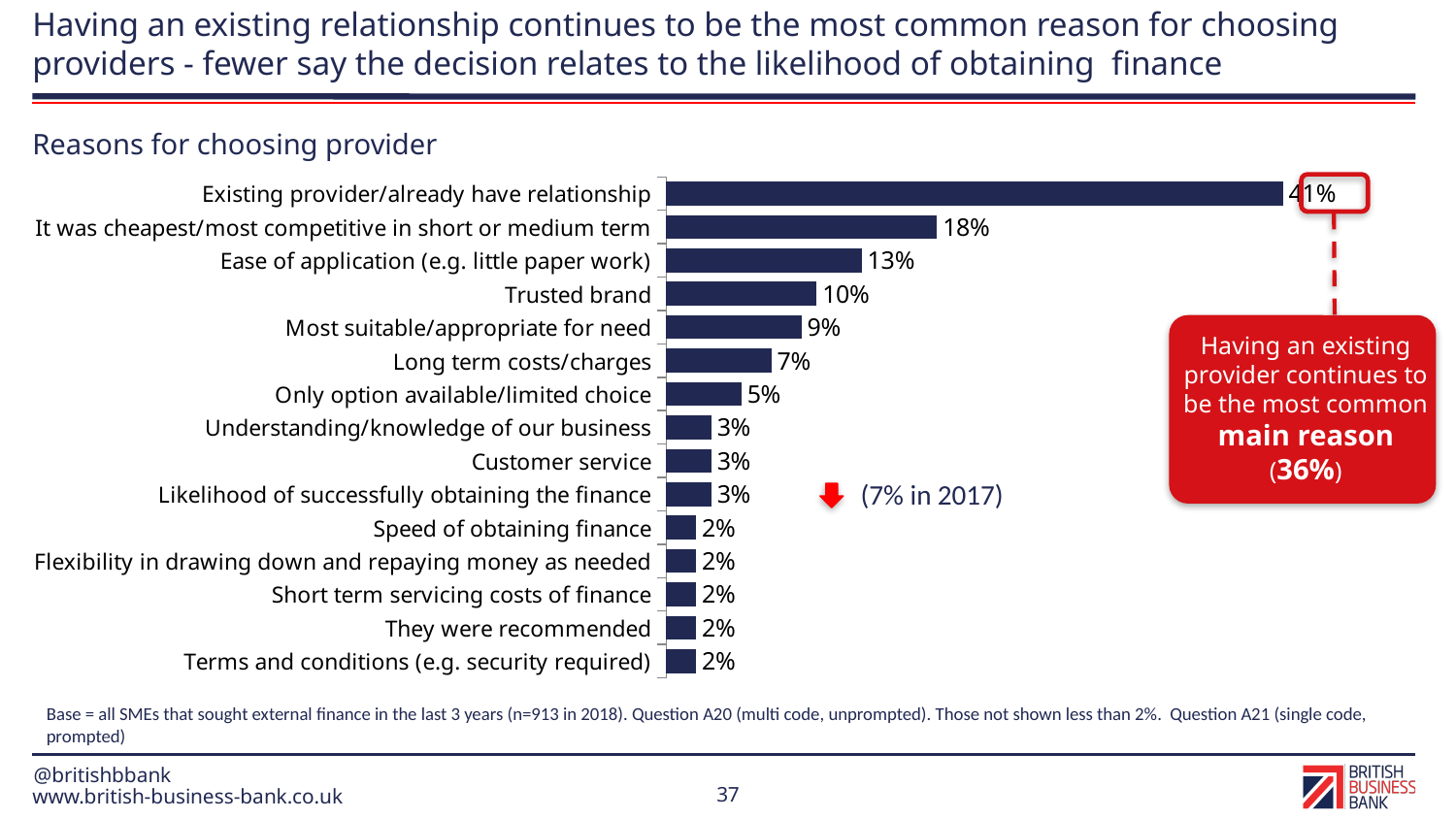
What is the value for 'Only option available/limited choice'? 5% Which is larger: 'Most suitable/appropriate for need' or 'Long term costs/charges'? Most suitable/appropriate for need What is the value for 'Trusted brand'? 10% What was the value for 'Likelihood of successfully obtaining the finance' in 2017, according to the annotation? 7% What is the difference between 'Existing provider/already have relationship' and 'It was cheapest/most competitive in short or medium term'? 23% What percentage of SMEs chose their provider because it was the existing provider/already had a relationship? 41% What is the value for 'Likelihood of successfully obtaining the finance'? 3% What kind of chart is used to show the reasons for choosing provider? Bar chart Which reason for choosing provider has the highest value? Existing provider/already have relationship What is the difference between 'It was cheapest/most competitive in short or medium term' and 'Ease of application (e.g. little paper work)'? 5% What is the title of the chart? Reasons for choosing provider How many reasons for choosing provider are shown in the chart? 15